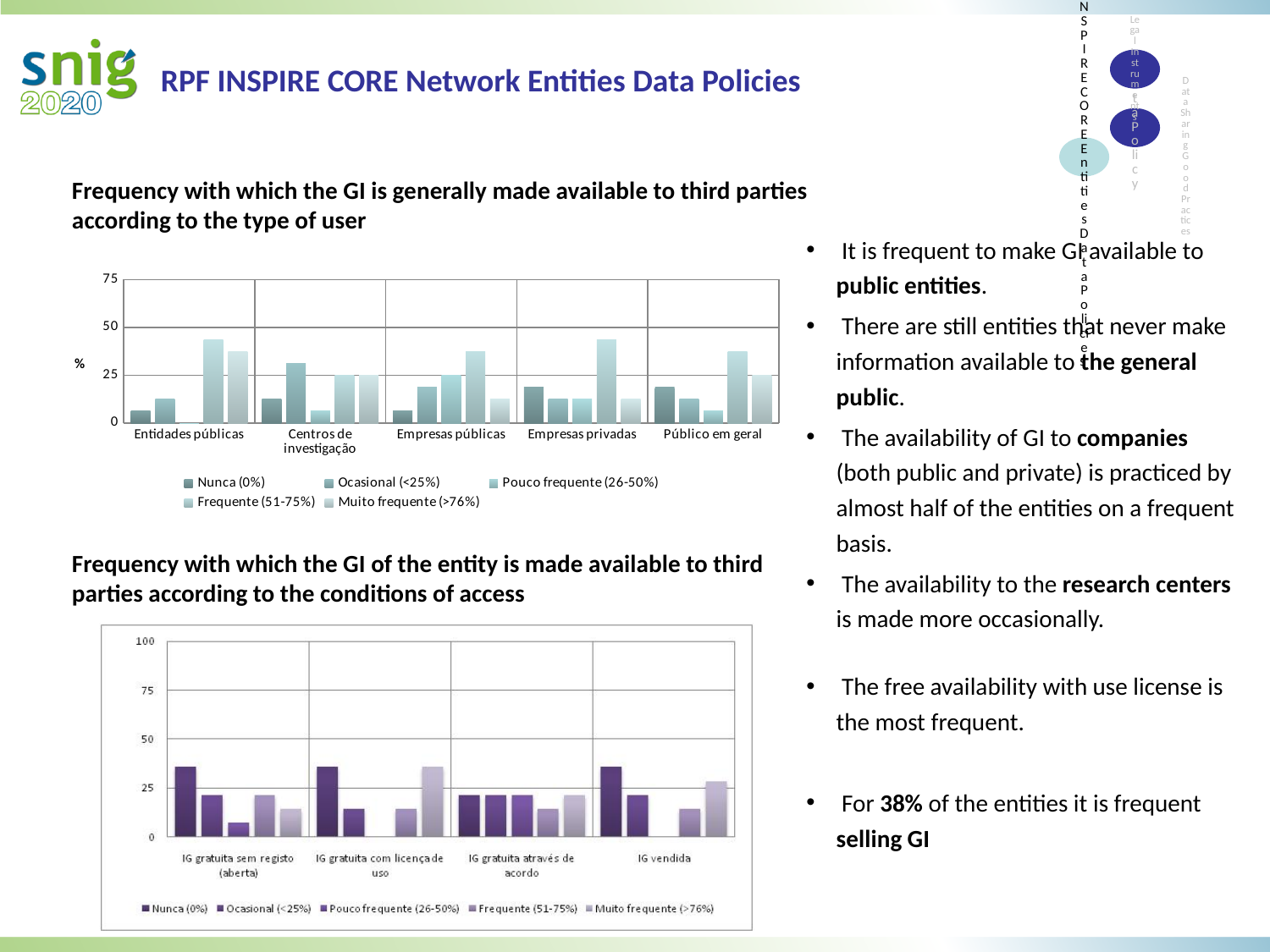
In the top chart (frequency according to the type of user), how many user-type categories are shown on the x axis? 5 In the bottom chart (frequency according to the conditions of access), how many series does the legend list? 5 In the top chart (frequency according to the type of user), is the value of 'Frequente (51-75%)' for 'Entidades públicas' greater or less than 25? greater In the top chart (frequency according to the type of user), for 'Centros de investigação', which is larger: 'Nunca (0%)' or 'Ocasional (<25%)'? Ocasional (<25%) In the top chart (frequency according to the type of user), what label is shown on the y axis? % In the bottom chart (frequency according to the conditions of access), is the value of 'Pouco frequente (26-50%)' for 'IG gratuita sem registo (aberta)' greater or less than 25? less In the top chart (frequency according to the type of user), how many series does the legend list? 5 In the top chart (frequency according to the type of user), which series has the highest value for 'Entidades públicas'? Frequente (51-75%) In the bottom chart (frequency according to the conditions of access), is the value of 'Nunca (0%)' for 'IG vendida' greater or less than 25? greater In the top chart (frequency according to the type of user), what kind of chart is shown? bar chart In the bottom chart (frequency according to the conditions of access), how many access-condition categories are shown on the x axis? 4